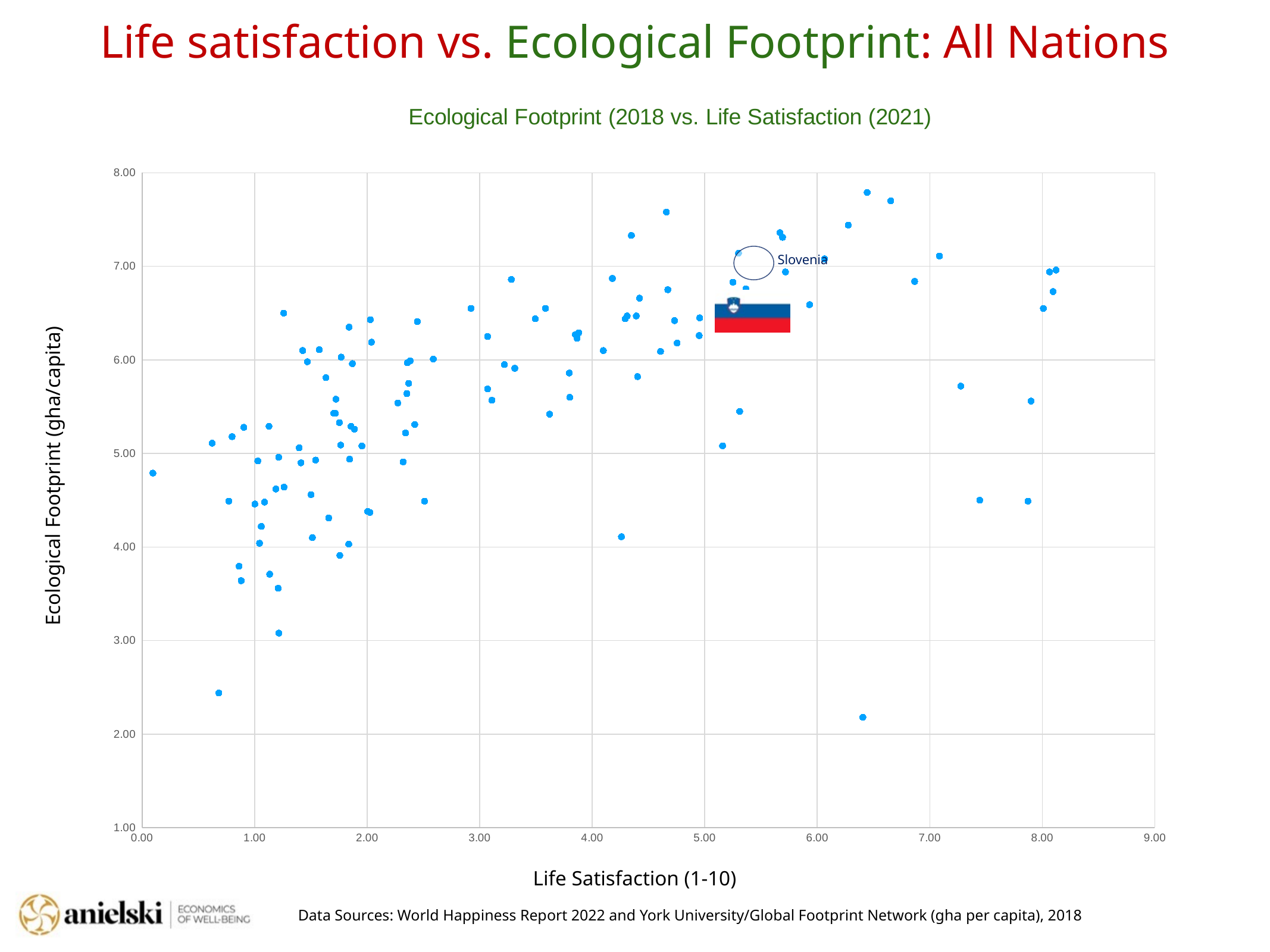
What is the lowest tick value shown on the y axis? 1.00 What is the highest tick value shown on the y axis? 8.00 Is the life satisfaction value for Slovenia greater or less than 5.00? greater Is the ecological footprint value for Slovenia greater or less than 8.00? less Do ecological footprint values generally rise or fall as life satisfaction increases along the x axis? rise Is the ecological footprint value for Slovenia greater or less than 6.00? greater What is the title printed above the chart? Ecological Footprint (2018 vs. Life Satisfaction (2021) What is the highest tick value shown on the x axis? 9.00 Which nation is labelled and circled on the chart? Slovenia What is the label of the x axis? Life Satisfaction (1-10) What kind of chart is shown on the slide? Scatter plot